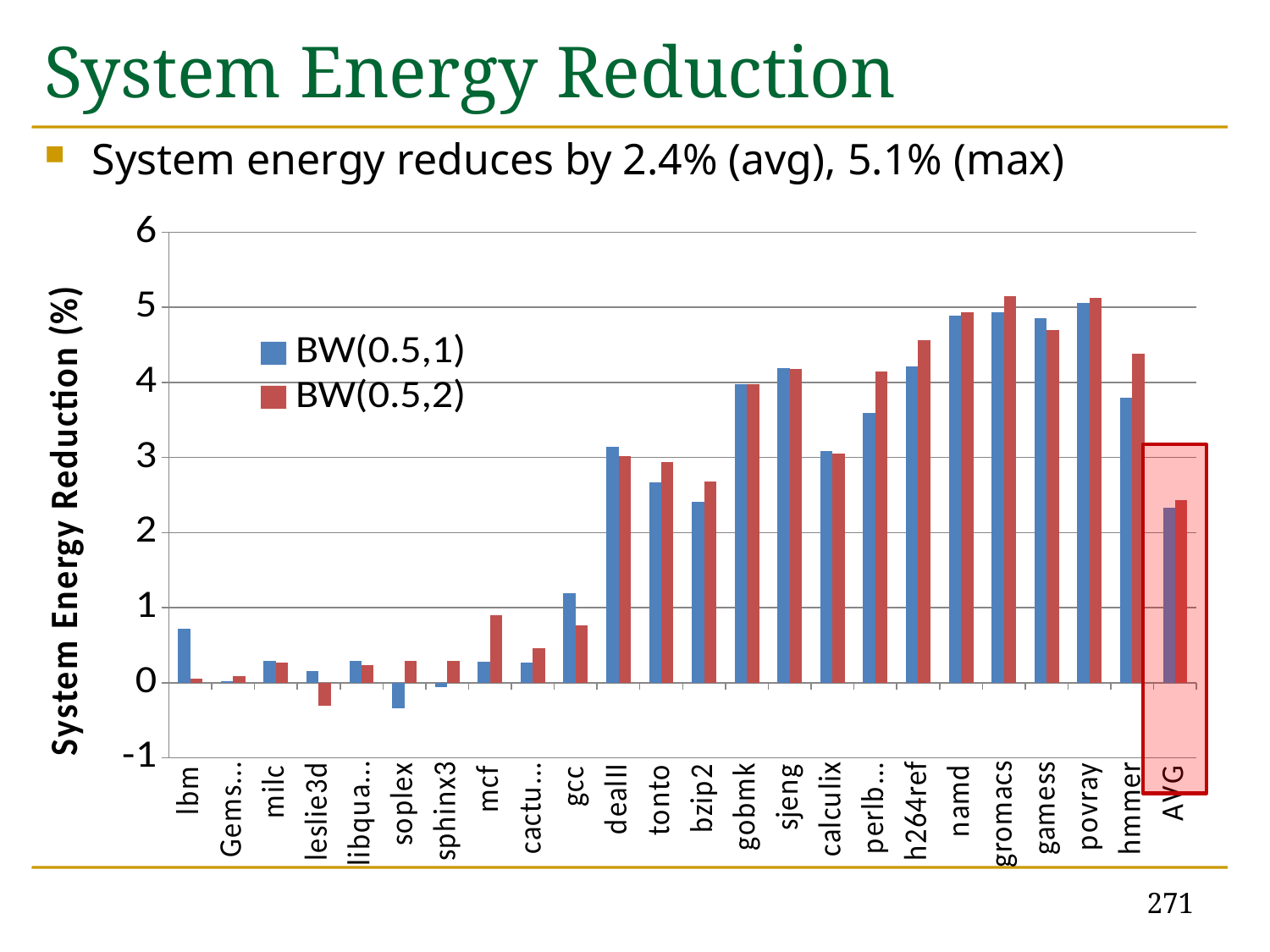
What are the two series named in the legend? BW(0.5,1) and BW(0.5,2) Is the BW(0.5,1) value for soplex greater or less than 0? less Is the BW(0.5,2) value for gobmk greater or less than 3? greater How many categories are shown along the x axis, including AVG? 24 Is the BW(0.5,1) value for hmmer greater or less than 4? less What is the label of the y axis? System Energy Reduction (%) What kind of chart is shown on the slide? bar chart For mcf, which series has the larger value, BW(0.5,1) or BW(0.5,2)? BW(0.5,2) For gcc, which series has the larger value, BW(0.5,1) or BW(0.5,2)? BW(0.5,1) Which category has the lowest BW(0.5,1) value? soplex How many series does the legend list? 2